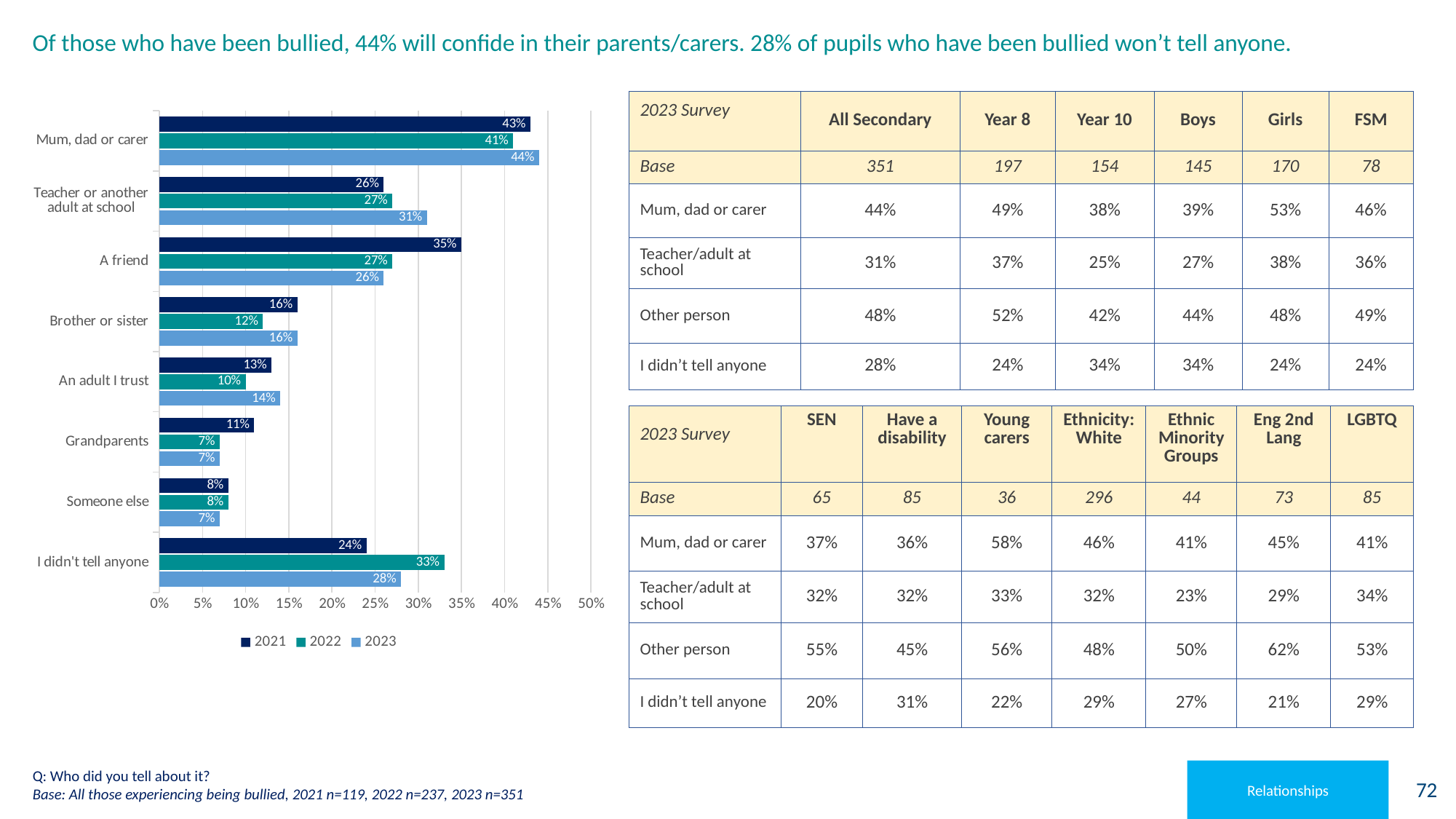
Which category has the lowest 2021 value in the chart? Someone else How many series does the chart legend list? 3 What is the 2023 value for 'A friend' in the chart? 26% What kind of chart is shown on the slide? bar chart In the chart, which is larger for 'A friend': the 2021 value or the 2022 value? 2021 Which category has the highest 2023 value in the chart? Mum, dad or carer Which series in the chart legend is shown in the darkest blue colour? 2021 What is the 2022 value for 'I didn't tell anyone' in the chart? 33% What is the difference between the 2021 and 2023 values for 'Teacher or another adult at school' in the chart? 5% Did the value for 'Grandparents' rise or fall from 2021 to 2022 in the chart? fall How many categories are shown on the chart? 8 What is the 2021 value for 'Brother or sister' in the chart? 16%